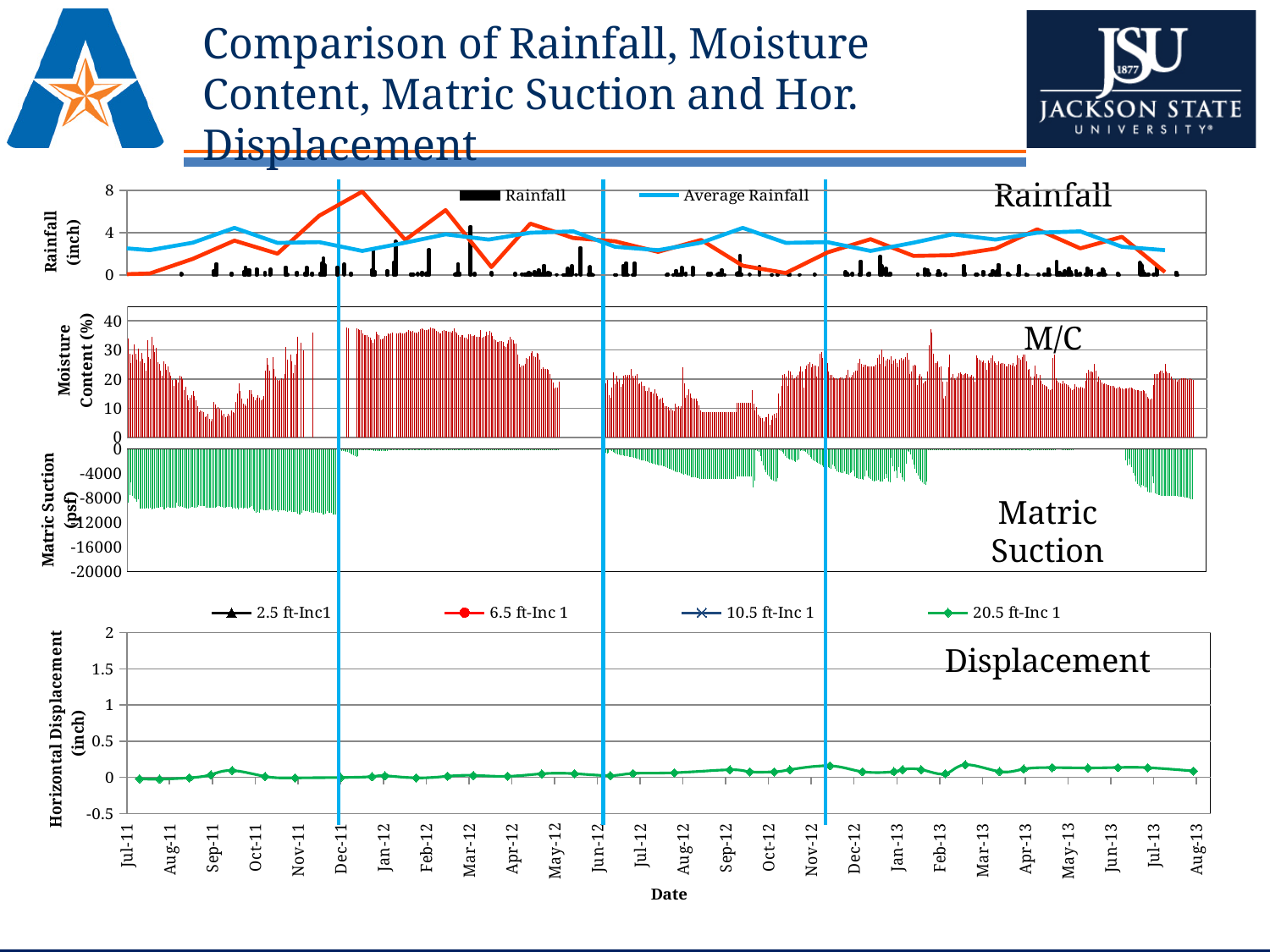
What kind of chart is the M/C (Moisture Content) chart? bar chart How many date labels are shown along the shared x axis (Date) at the bottom of the slide? 26 In the Displacement chart, how many series does the legend list? 4 What kind of chart is the Displacement chart at the bottom of the slide? line chart In the Displacement chart, is the horizontal displacement at Aug-13 greater or less than 0.5? less In the Rainfall chart, is the Average Rainfall value at Jul-11 greater or less than 4? less In the Rainfall chart, how many series does the legend list? 2 In the Matric Suction chart, is the value around Sep-11 greater or less than -4000? less How many vertical blue lines are drawn across the charts on the slide? 3 What kind of chart is the Rainfall chart at the top of the slide? bar and line chart